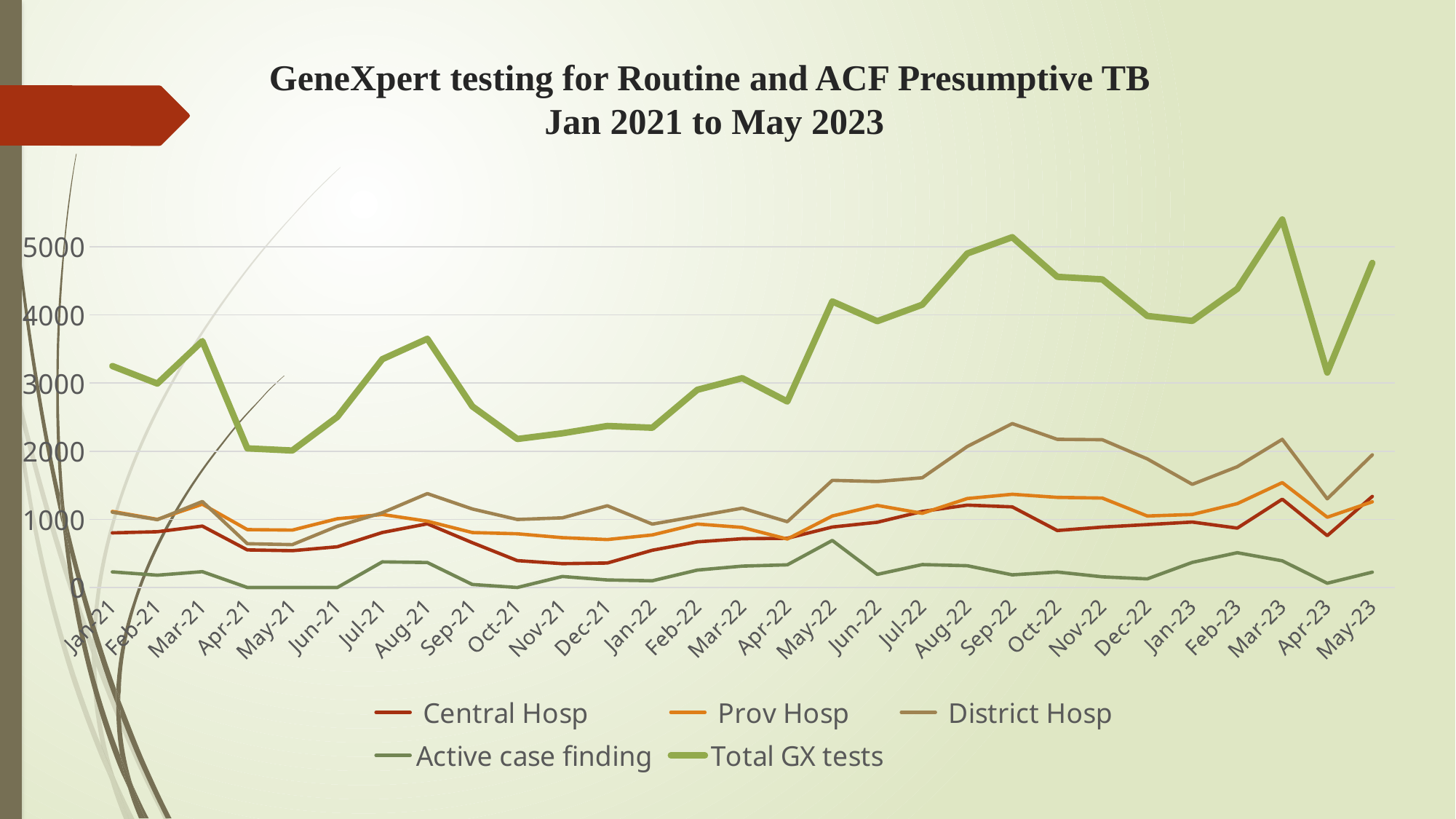
Which series has the highest values throughout the chart? Total GX tests Is the value for District Hosp in Sep-22 greater or less than 2000? greater Which series has the lowest values throughout the chart? Active case finding Is the value for Central Hosp in Oct-21 greater or less than 1000? less How many months are plotted along the x axis? 29 Which is larger for Total GX tests: the value in Sep-22 or the value in Jan-22? Sep-22 Is the value for Total GX tests in Mar-23 greater or less than 5000? greater In which month does the Total GX tests line reach its highest value? Mar-23 What is the title of the chart? GeneXpert testing for Routine and ACF Presumptive TB Jan 2021 to May 2023 How many series does the legend list? 5 What kind of chart is shown on the slide? line chart